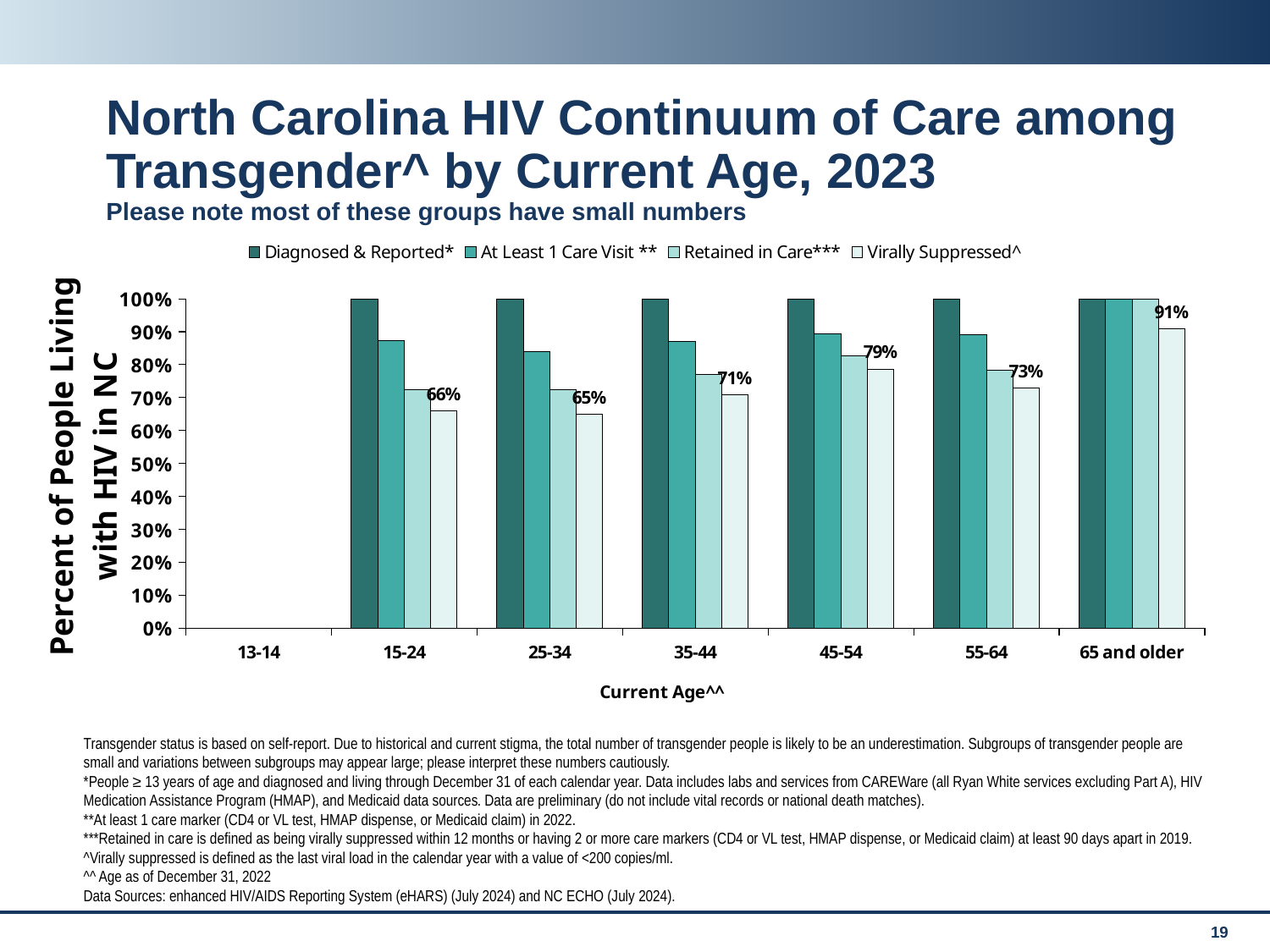
What kind of chart is shown on the slide? Bar chart What is the difference between the Virally Suppressed values for the 45-54 and 35-44 age groups? 8% How many series does the legend list? 4 Is the Retained in Care value for the 25-34 age group greater or less than 80%? less Which age group has the highest Virally Suppressed value? 65 and older Is the At Least 1 Care Visit value for the 15-24 age group greater or less than 80%? greater Which is larger, the Virally Suppressed value for 55-64 or for 25-34? 55-64 Which age group has the lowest Virally Suppressed value among those with data labels? 25-34 How many age groups are shown on the x axis? 7 What is the Virally Suppressed value for the 15-24 age group? 66% What is the Virally Suppressed value for the 45-54 age group? 79% What is the Virally Suppressed value for the 65 and older age group? 91%